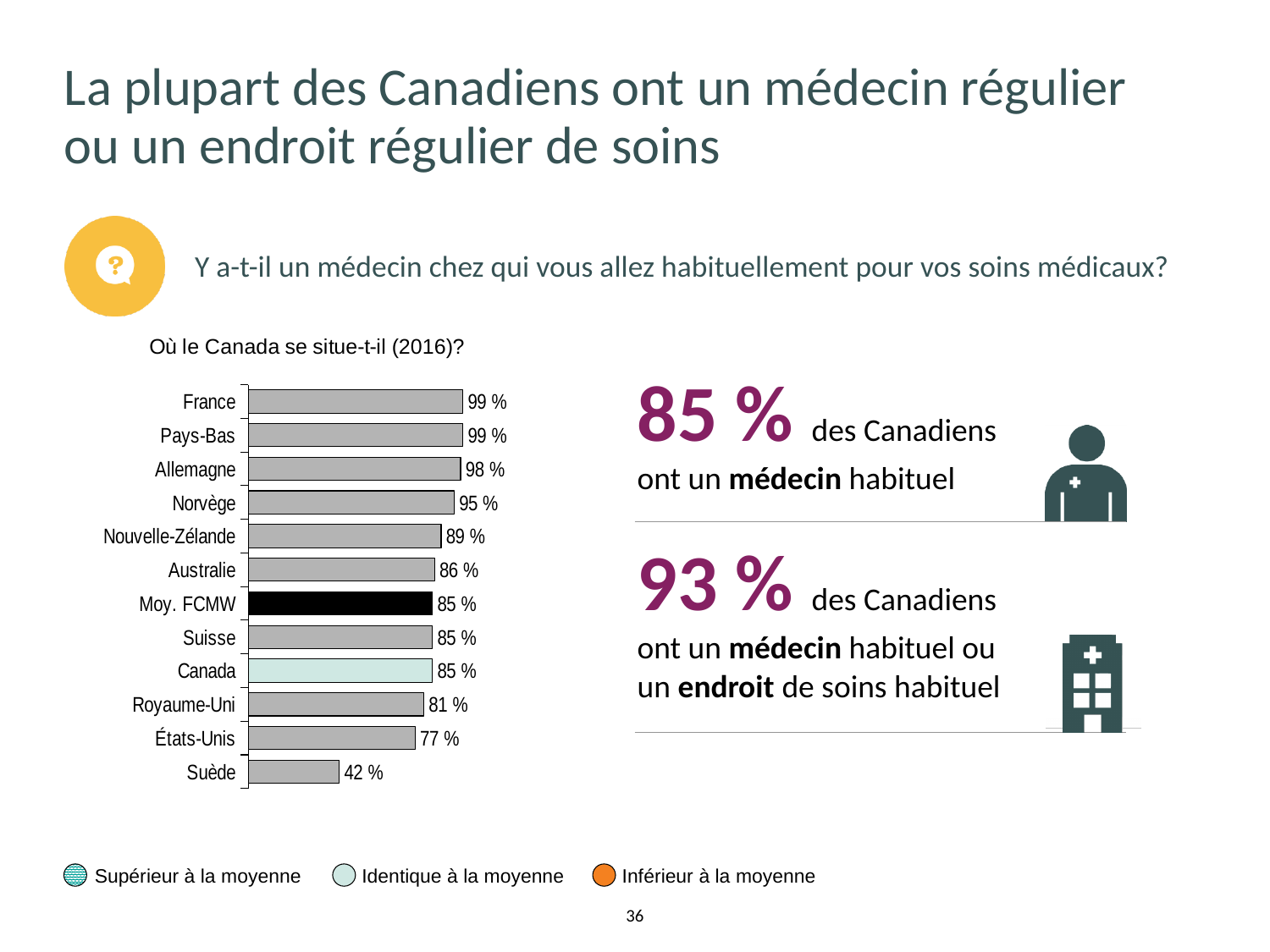
What is the difference between the values for Canada and Suède? 43 % What is the value for Moy. FCMW in the chart? 85 % Which has a higher value, Nouvelle-Zélande or États-Unis? Nouvelle-Zélande What is the value for Allemagne in the chart? 98 % What type of chart is shown on the slide? Bar chart What is the difference between the values for Norvège and États-Unis? 18 % Which country has the lowest value in the chart? Suède How many bars are shown in the chart? 12 What is the title of the chart? Où le Canada se situe-t-il (2016)? What is the value for Suède in the chart? 42 % What is the value for Canada in the chart? 85 % Which has a higher value, Australie or Royaume-Uni? Australie